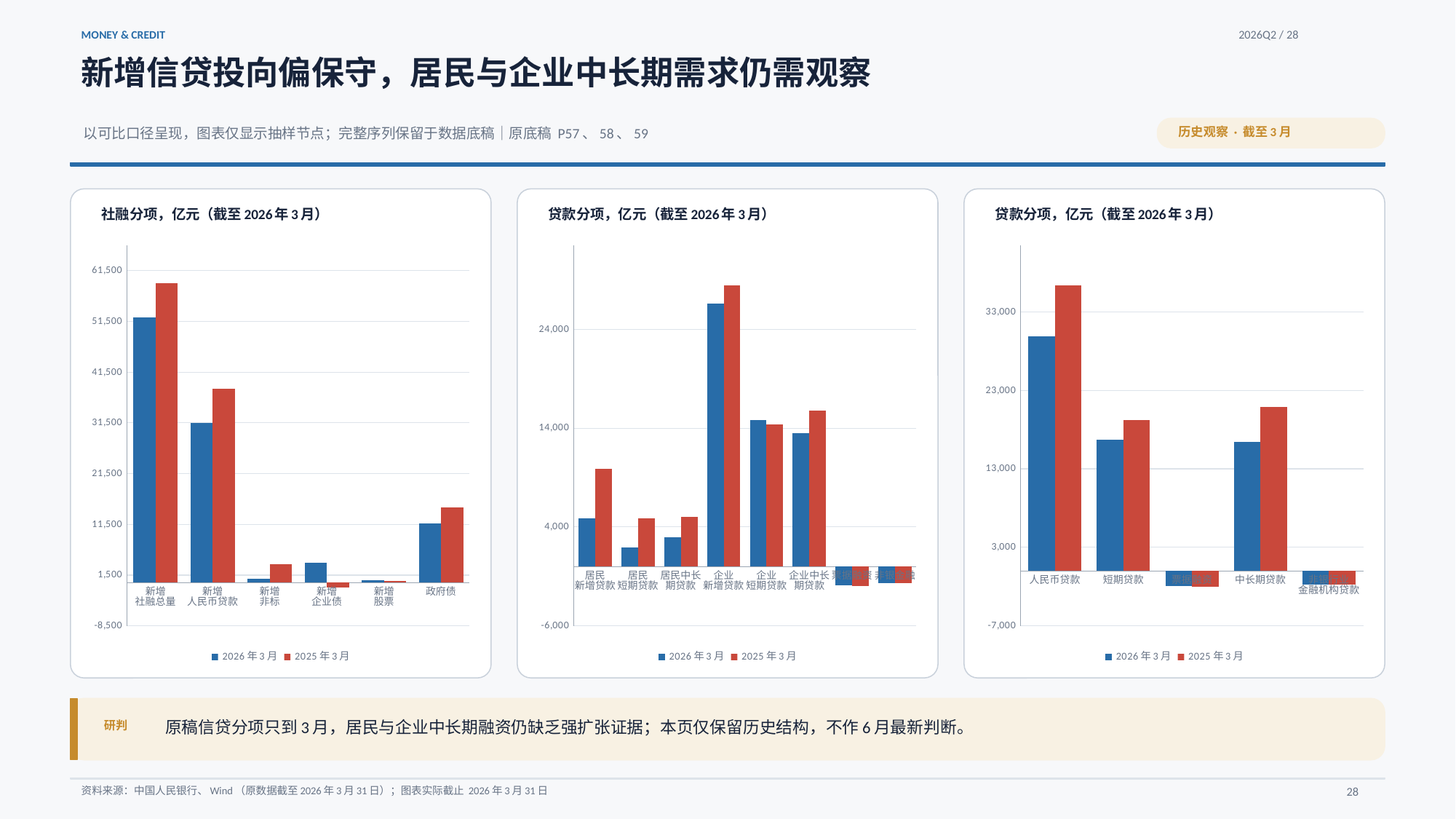
In the left chart (社融分项), which category has the highest value for 2026 年 3 月? 新增社融总量 In the left chart (社融分项), is the 2026 年 3 月 value for 新增社融总量 greater or less than 41,500? greater In the middle chart (贷款分项), for 居民新增贷款, which series is larger: 2026 年 3 月 or 2025 年 3 月? 2025 年 3 月 What kind of chart is the left chart titled 社融分项，亿元（截至 2026 年 3 月）? bar chart In the middle chart (贷款分项), which category has the highest value for 2026 年 3 月? 企业新增贷款 In the left chart (社融分项), for 新增人民币贷款, which series is larger: 2026 年 3 月 or 2025 年 3 月? 2025 年 3 月 In the middle chart (贷款分项), is the 2026 年 3 月 value for 企业新增贷款 greater or less than 24,000? greater In the left chart (社融分项), how many categories are shown on the x axis? 6 In the left chart (社融分项), is the 2026 年 3 月 value for 政府债 greater or less than 21,500? less In the right chart (贷款分项), which category has the highest value for 2025 年 3 月? 人民币贷款 In the left chart (社融分项), how many series does the legend list? 2